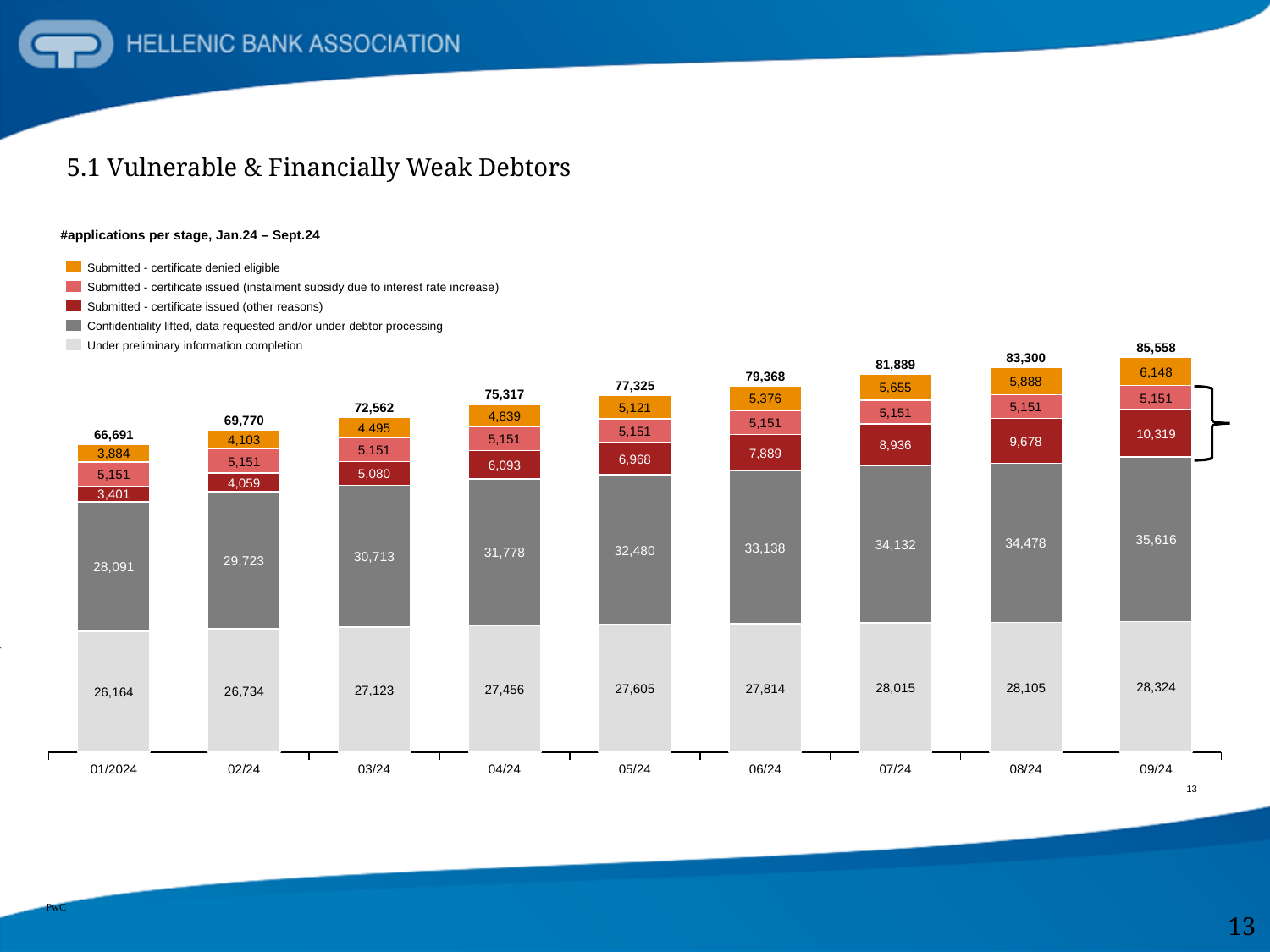
How many months are shown on the x axis? 9 Which month has the highest total number of applications? 09/24 Do the total applications rise or fall from 01/2024 to 09/24? rise What is the value of 'Submitted - certificate denied eligible' for 03/24? 4,495 Which is larger: 'Submitted - certificate issued (other reasons)' for 07/24 or 'Submitted - certificate denied eligible' for 07/24? Submitted - certificate issued (other reasons) How many series does the legend list? 5 Which month has the lowest total number of applications? 01/2024 What is the value of 'Confidentiality lifted, data requested and/or under debtor processing' for 05/24? 32,480 What is the difference between the total for 09/24 and the total for 01/2024? 18,867 What is the value of 'Under preliminary information completion' for 01/2024? 26,164 What is the value of 'Submitted - certificate issued (other reasons)' for 08/24? 9,678 What is the total number of applications shown for 09/24? 85,558